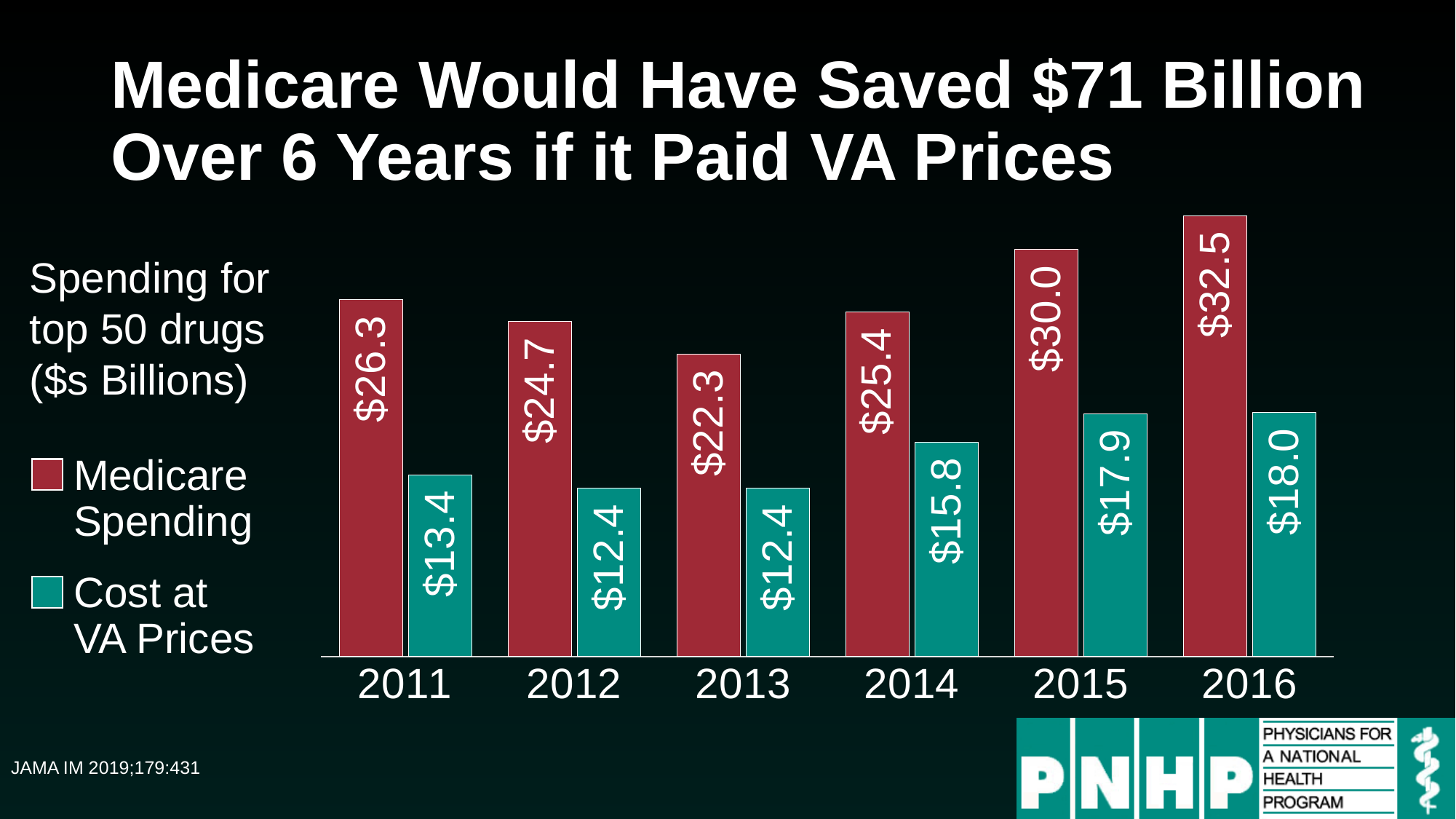
How many series does the legend list? 2 In which year was Medicare Spending lowest? 2013 What kind of chart is shown on the slide? Bar chart What is the difference between Medicare Spending in 2016 and in 2011? $6.2 What is the difference between Medicare Spending and Cost at VA Prices in 2015? $12.1 How many years are shown on the x axis? 6 What was the Cost at VA Prices in 2014? $15.8 Which is larger: Cost at VA Prices in 2011 or in 2012? 2011 In which year was Medicare Spending highest? 2016 What was Medicare Spending in 2013? $22.3 Which colour represents Cost at VA Prices in the chart? Teal What was Medicare Spending in 2016? $32.5